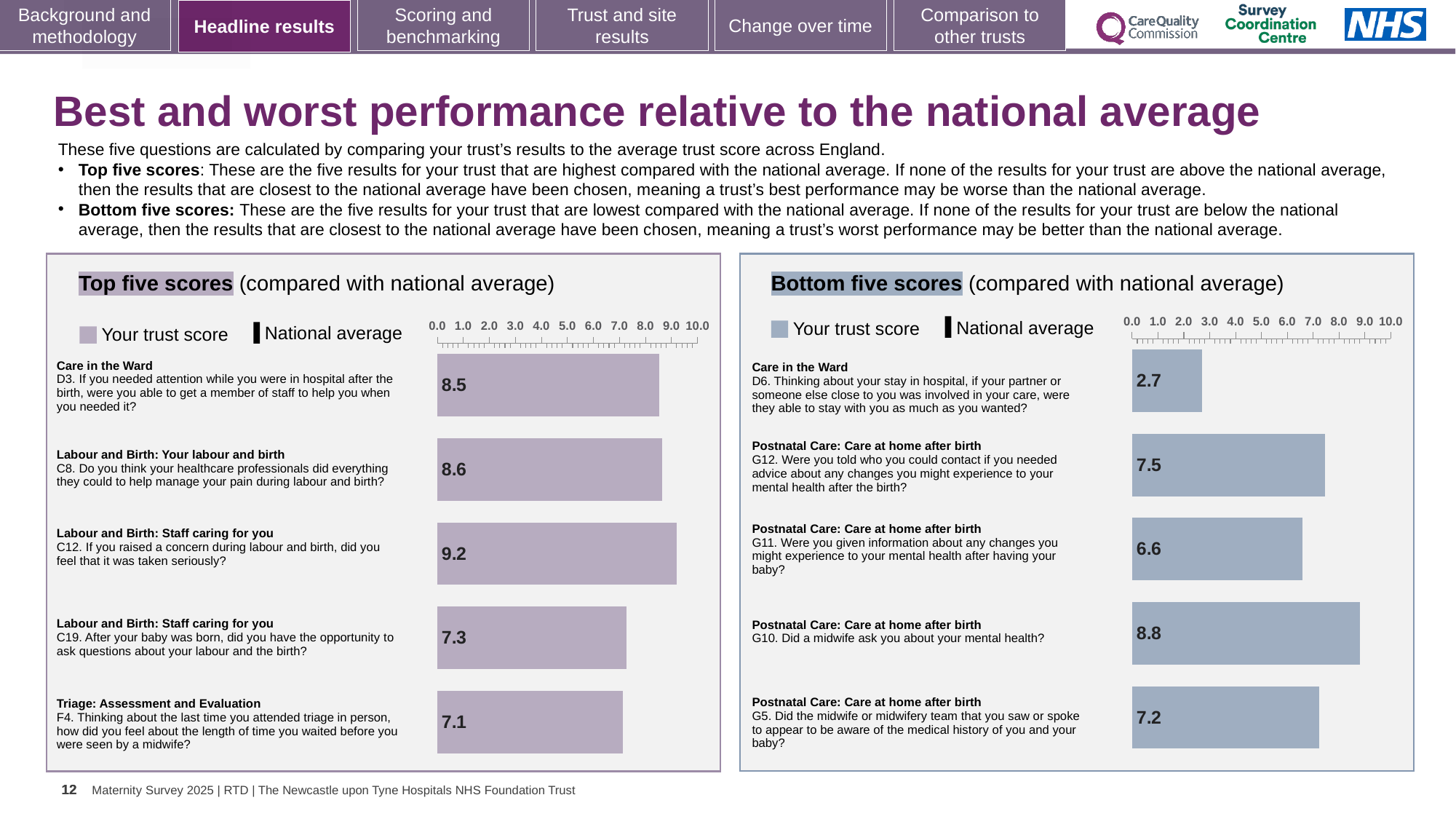
In the Bottom five scores chart, which question has the highest trust score? G10 (Did a midwife ask you about your mental health?) In the Top five scores chart, what is the difference between the trust scores for C12 and F4? 2.1 How many series does the legend of the Top five scores chart list? 2 In the Bottom five scores chart, which has the larger trust score, G10 or G12? G10 In the Top five scores chart, is the trust score for C19 greater or less than 8.0? less In the Top five scores chart, what is the trust score for F4 (Triage: Assessment and Evaluation)? 7.1 How many bars are shown in the Bottom five scores chart? 5 In the Top five scores chart, which question has the highest trust score? C12 (Labour and Birth: Staff caring for you) In the Bottom five scores chart, what is the trust score for D6 (Care in the Ward)? 2.7 In the Bottom five scores chart, which question has the lowest trust score? D6 (Care in the Ward) In the Top five scores chart, what is the trust score for C12 (If you raised a concern during labour and birth, did you feel that it was taken seriously?)? 9.2 What kind of chart is the Top five scores chart? Bar chart